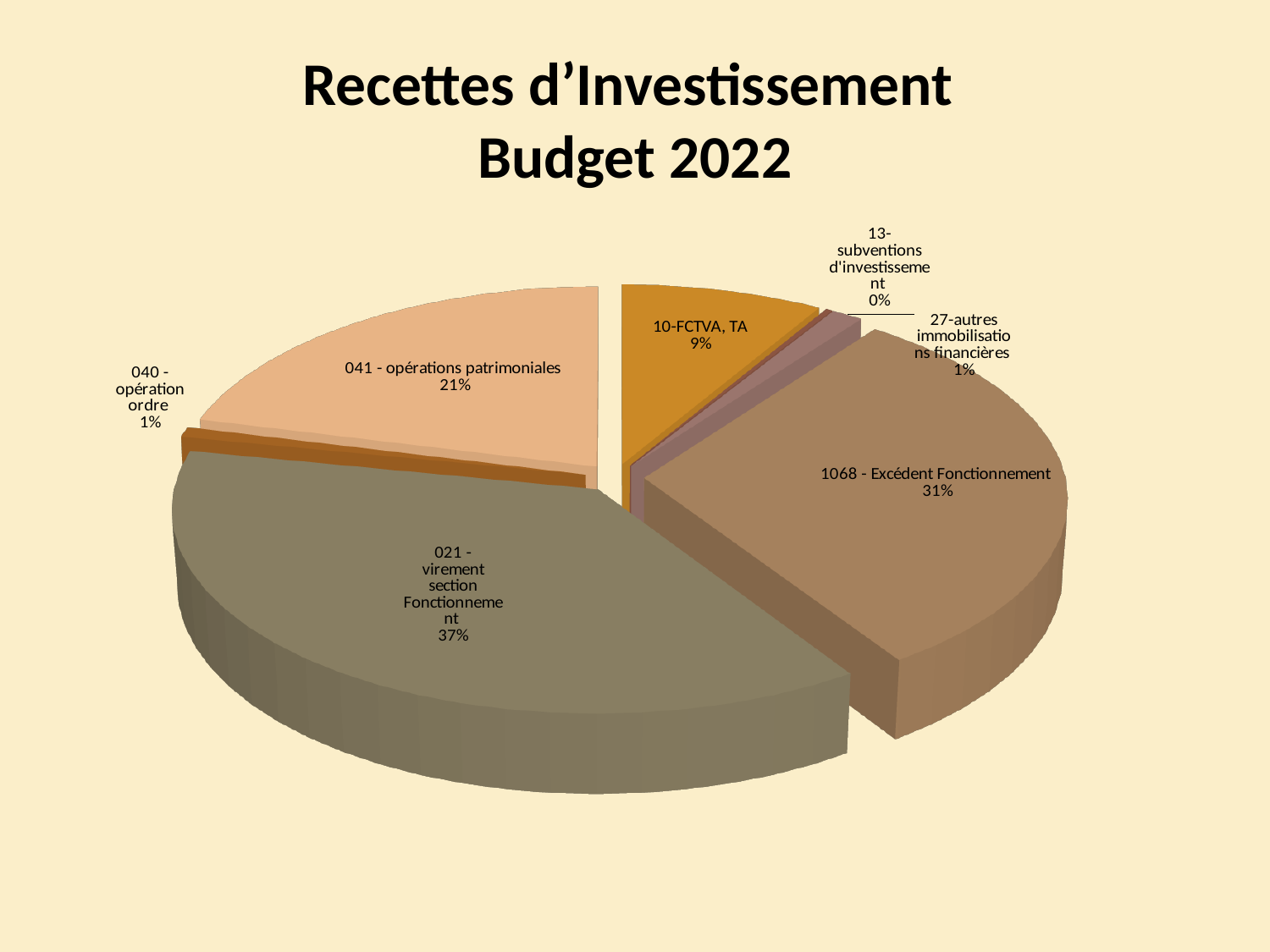
Which is larger: '041 - opérations patrimoniales' or '10-FCTVA, TA'? 041 - opérations patrimoniales What percentage is shown for '041 - opérations patrimoniales'? 21% What percentage is shown for '10-FCTVA, TA'? 9% What is the difference in percentage points between '021 - virement section Fonctionnement' and '1068 - Excédent Fonctionnement'? 6 What share of the pie does '021 - virement section Fonctionnement' represent? 37% What share of the pie does '1068 - Excédent Fonctionnement' represent? 31% What kind of chart is shown on the slide? Pie chart What is the title of the chart? Recettes d'Investissement Budget 2022 How many categories are shown in the pie chart? 7 Which category has the smallest share of the pie? 13-subventions d'investissement What percentage is shown for '13-subventions d'investissement'? 0% Which category has the largest share of the pie? 021 - virement section Fonctionnement